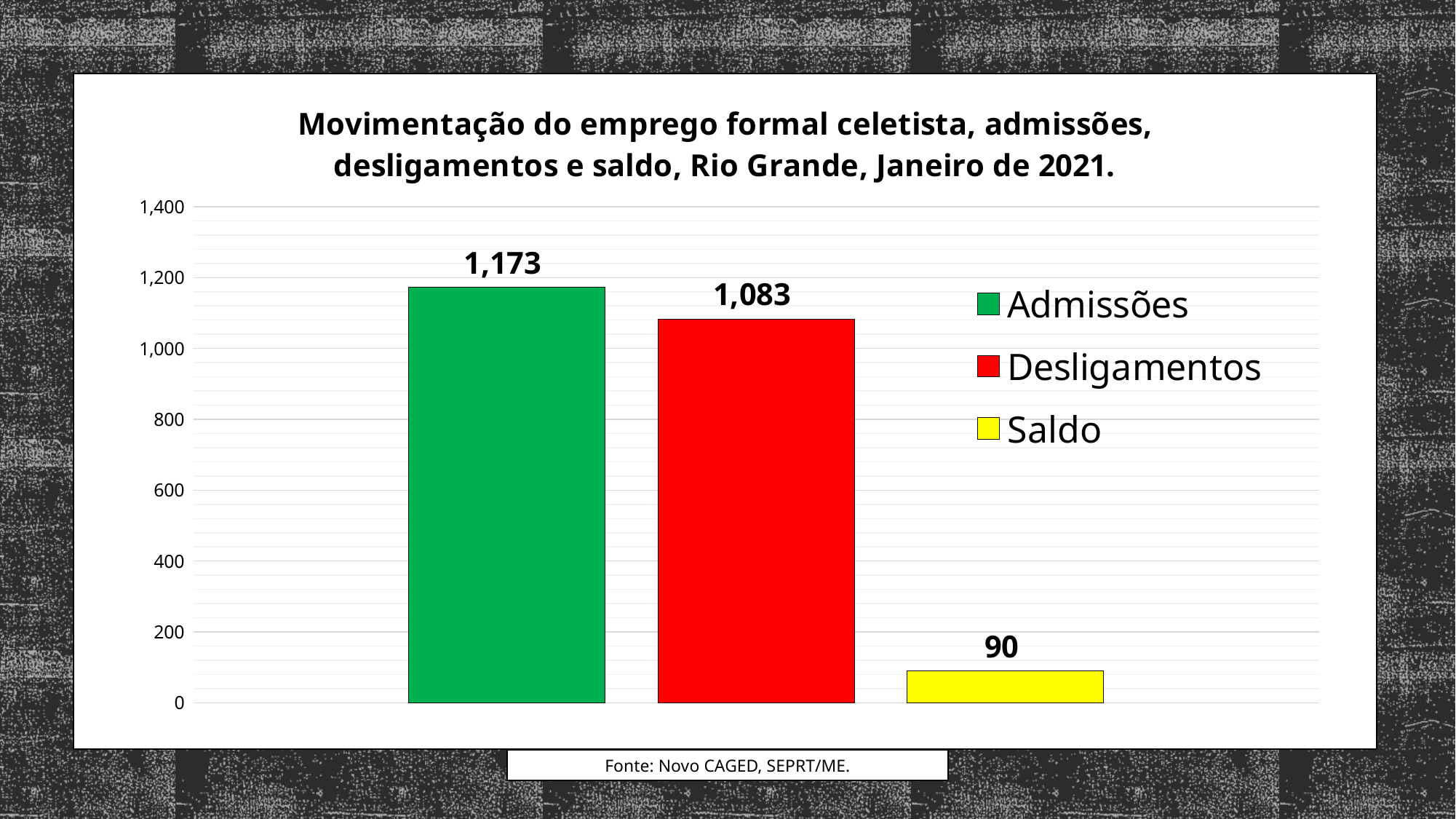
What colour is the bar for Saldo? yellow Which series has the highest value? Admissões What kind of chart is shown on the slide? bar chart Which series has the lowest value? Saldo What is the value for Admissões? 1,173 How many bars are plotted in the chart? 3 Which is larger, Desligamentos or Saldo? Desligamentos What is the value for Desligamentos? 1,083 Is the value for Desligamentos greater or less than 1,000? greater How many series does the legend list? 3 What is the difference between Admissões and Desligamentos? 90 What is the value for Saldo? 90